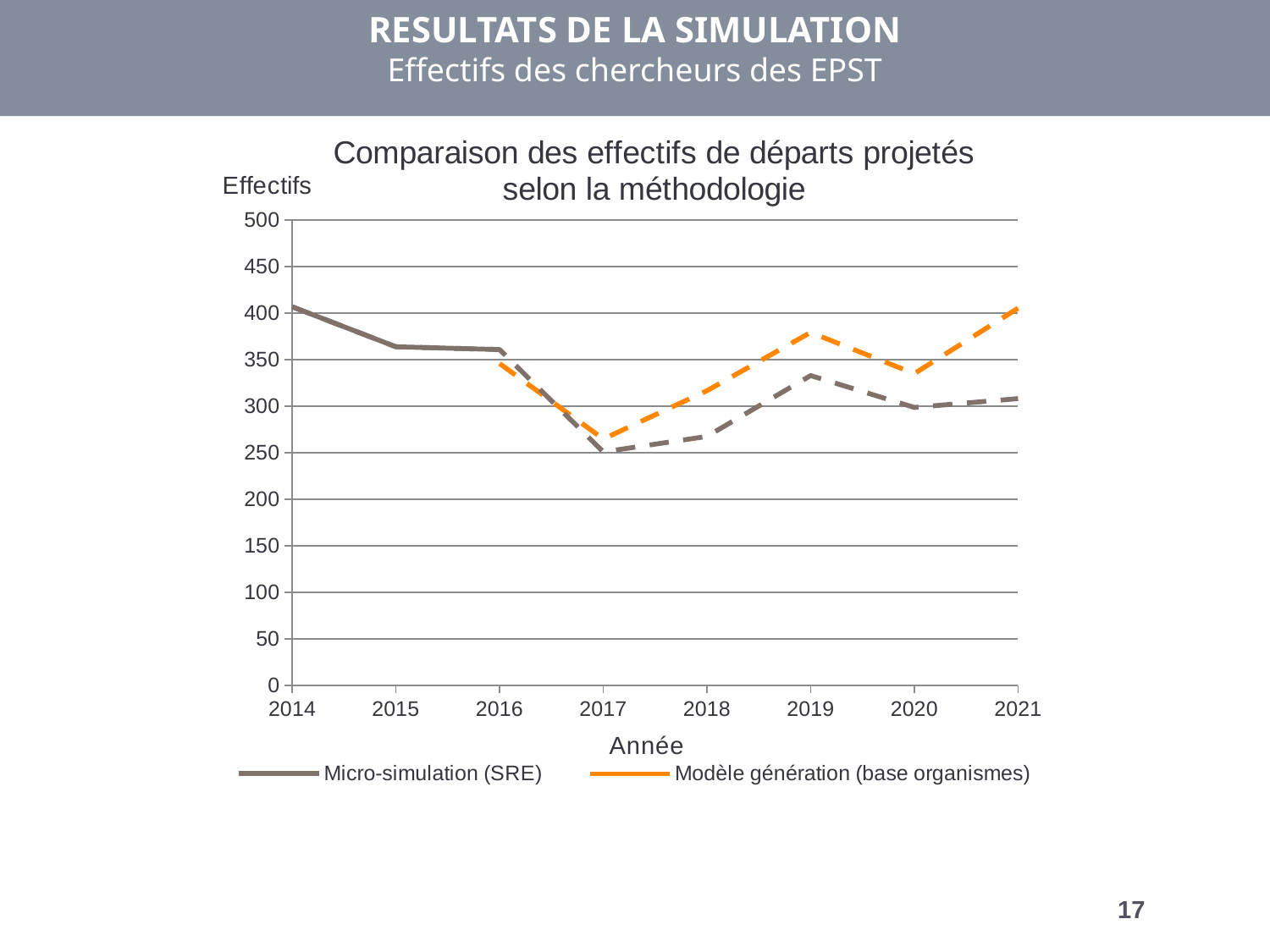
In 2019, which series has the higher value, Micro-simulation (SRE) or Modèle génération (base organismes)? Modèle génération (base organismes) How many series does the legend list? 2 In which year does the Modèle génération (base organismes) series reach its highest value? 2021 What kind of chart is shown on the slide? Line chart What is the label of the x axis? Année In which year does the Micro-simulation (SRE) series reach its highest value? 2014 Does the Micro-simulation (SRE) series rise or fall from 2014 to 2017? Fall How many years are shown on the x axis? 8 Is the Micro-simulation (SRE) value for 2017 greater or less than 300? less Is the Modèle génération (base organismes) value for 2021 greater or less than 350? greater Is the Micro-simulation (SRE) value for 2014 greater or less than 350? greater In which year does the Micro-simulation (SRE) series reach its lowest value? 2017